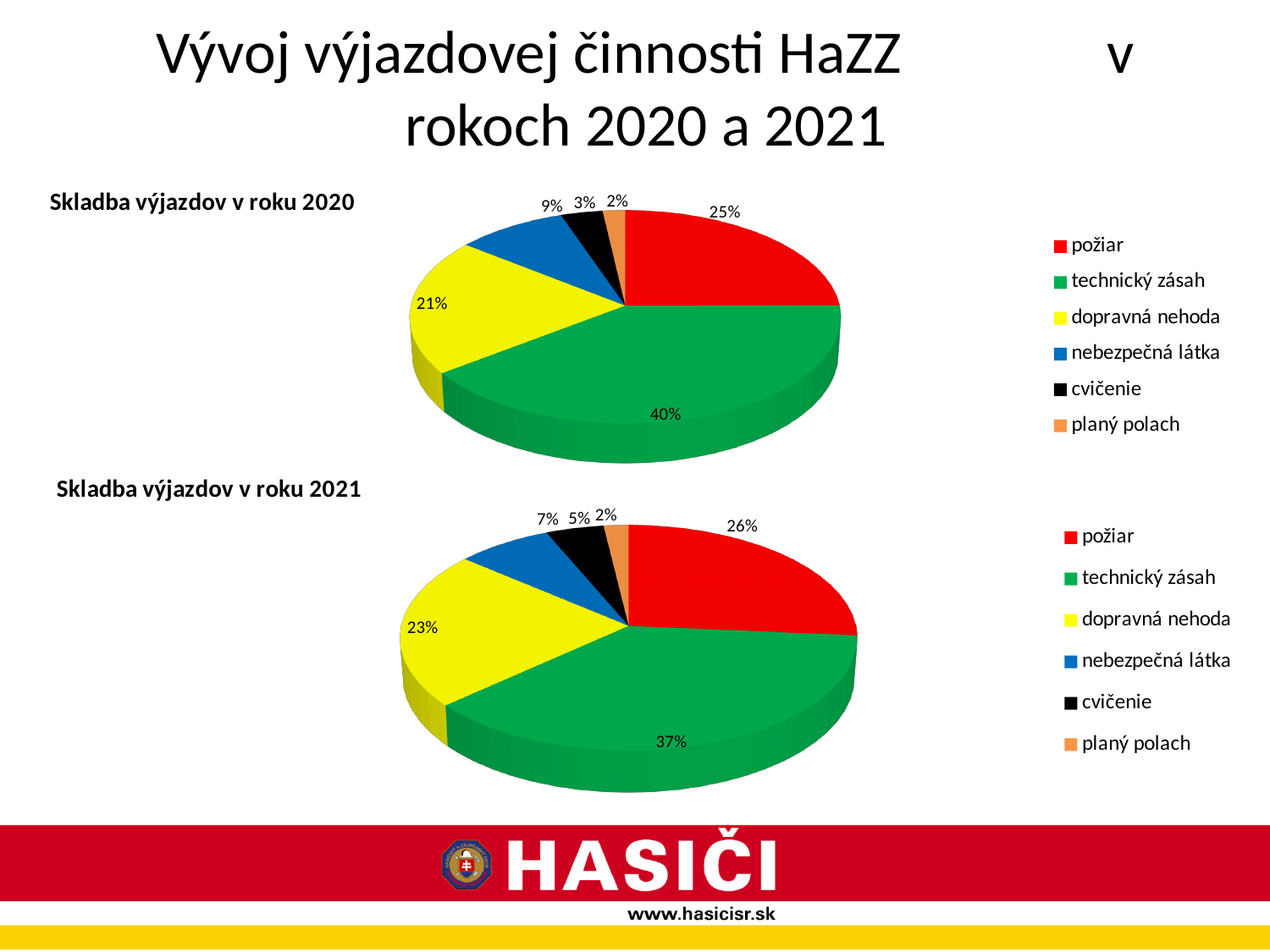
In the 'Skladba výjazdov v roku 2020' chart, which category has the largest slice? technický zásah In the 'Skladba výjazdov v roku 2021' chart, what is the difference between the shares of technický zásah and požiar? 11% How many categories does the legend of the 'Skladba výjazdov v roku 2020' chart list? 6 In the 'Skladba výjazdov v roku 2021' chart, what share does dopravná nehoda have? 23% In the 'Skladba výjazdov v roku 2021' chart, what share does technický zásah have? 37% In the 'Skladba výjazdov v roku 2020' chart, what share does nebezpečná látka have? 9% In the 'Skladba výjazdov v roku 2021' chart, which is larger, the share of dopravná nehoda or the share of nebezpečná látka? dopravná nehoda In the 'Skladba výjazdov v roku 2020' chart, which category has the smallest slice? planý polach What type of chart is 'Skladba výjazdov v roku 2021'? pie chart